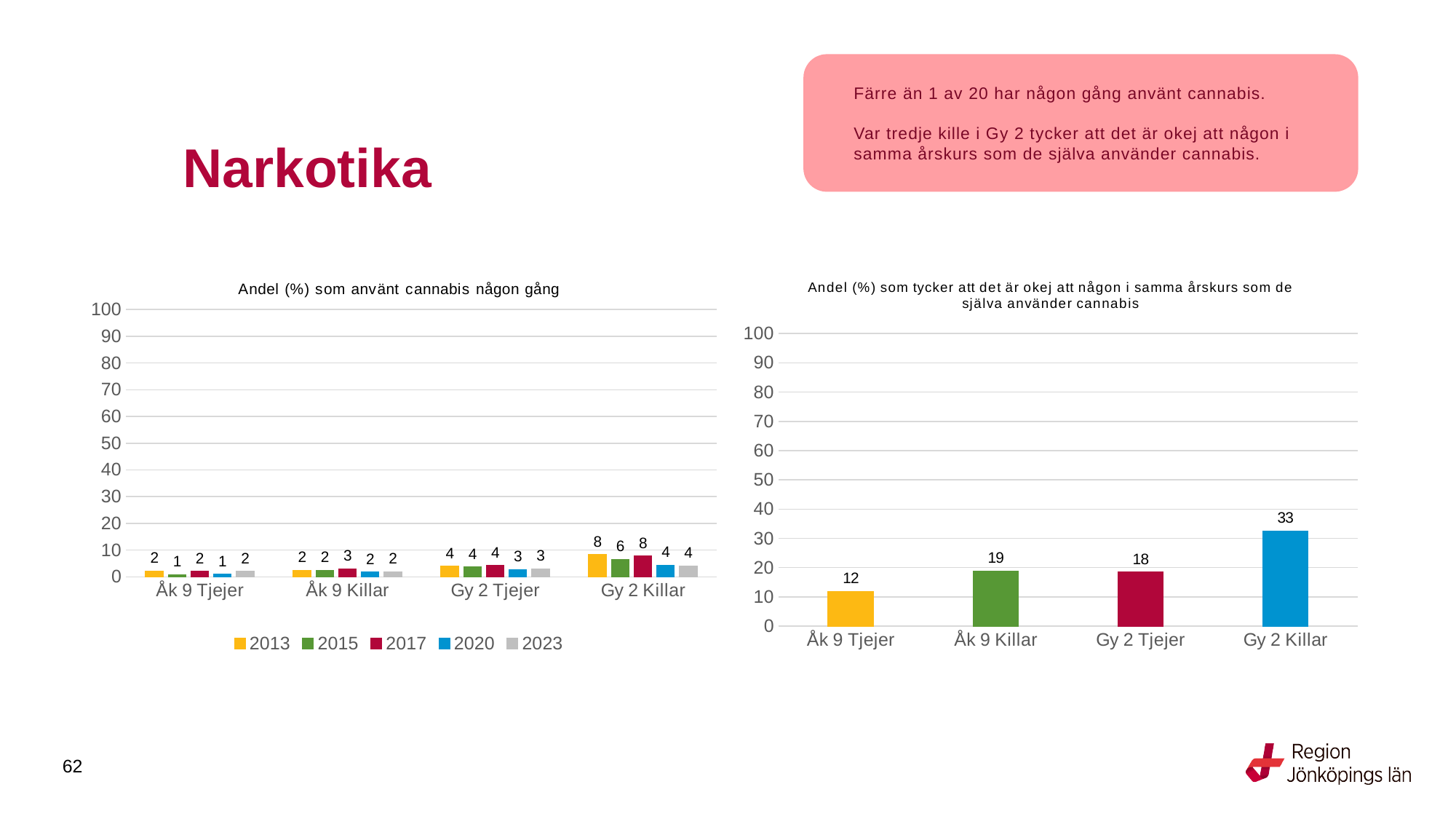
In the left chart 'Andel (%) som använt cannabis någon gång', what is the value for Gy 2 Killar in 2013? 8 In the right chart 'Andel (%) som tycker att det är okej...', what is the difference between Gy 2 Killar and Gy 2 Tjejer? 15 In the right chart 'Andel (%) som tycker att det är okej...', which is larger, Åk 9 Killar or Åk 9 Tjejer? Åk 9 Killar In the left chart 'Andel (%) som använt cannabis någon gång', what kind of chart is shown? Bar chart In the right chart 'Andel (%) som tycker att det är okej...', is the value for Gy 2 Killar greater or less than 30? greater In the left chart 'Andel (%) som använt cannabis någon gång', what is the difference between the 2013 and 2023 values for Gy 2 Killar? 4 In the right chart 'Andel (%) som tycker att det är okej...', what is the value for Gy 2 Killar? 33 In the right chart 'Andel (%) som tycker att det är okej...', which category has the lowest value? Åk 9 Tjejer In the right chart 'Andel (%) som tycker att det är okej...', how many categories are shown on the x axis? 4 In the left chart 'Andel (%) som använt cannabis någon gång', what is the value for Åk 9 Killar in 2017? 3 In the left chart 'Andel (%) som använt cannabis någon gång', which category has the highest value in 2017? Gy 2 Killar In the left chart 'Andel (%) som använt cannabis någon gång', how many series does the legend list? 5